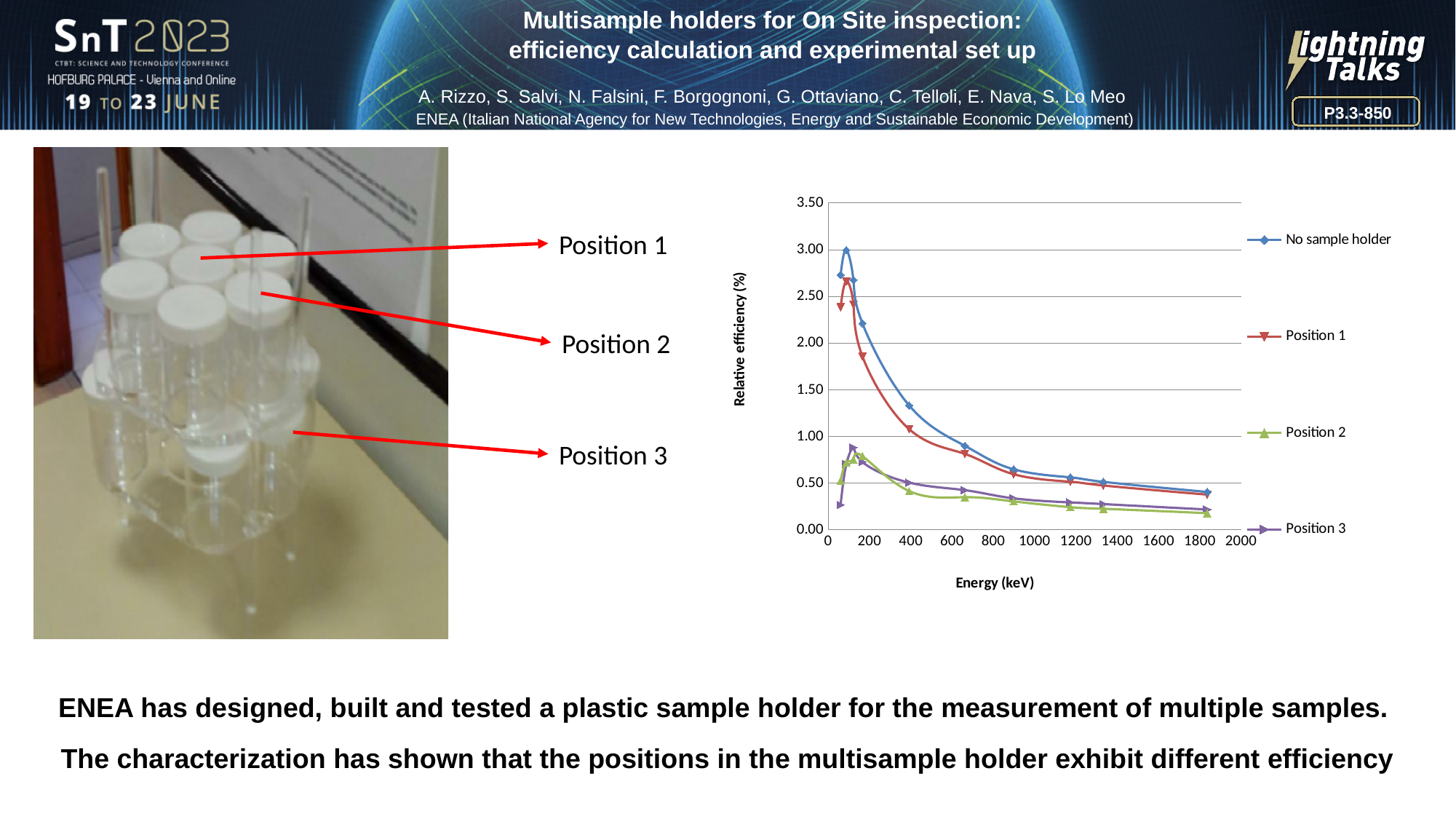
Is the value of the No sample holder series at its last point (around 1800 keV) greater or less than 0.50? less Which series reaches the highest relative efficiency on the chart? No sample holder What is the title of the x axis of the chart? Energy (keV) What is the title of the y axis of the chart? Relative efficiency (%) After their initial peak at low energy, do the relative efficiency values rise or fall as energy increases? fall At around 400 keV, which series has the larger relative efficiency: No sample holder or Position 1? No sample holder Is the peak value of the Position 1 series greater or less than 2.00? greater What kind of chart is shown on the slide? Line chart How many series does the chart legend list? 4 Is the peak value of the No sample holder series greater or less than 2.50? greater